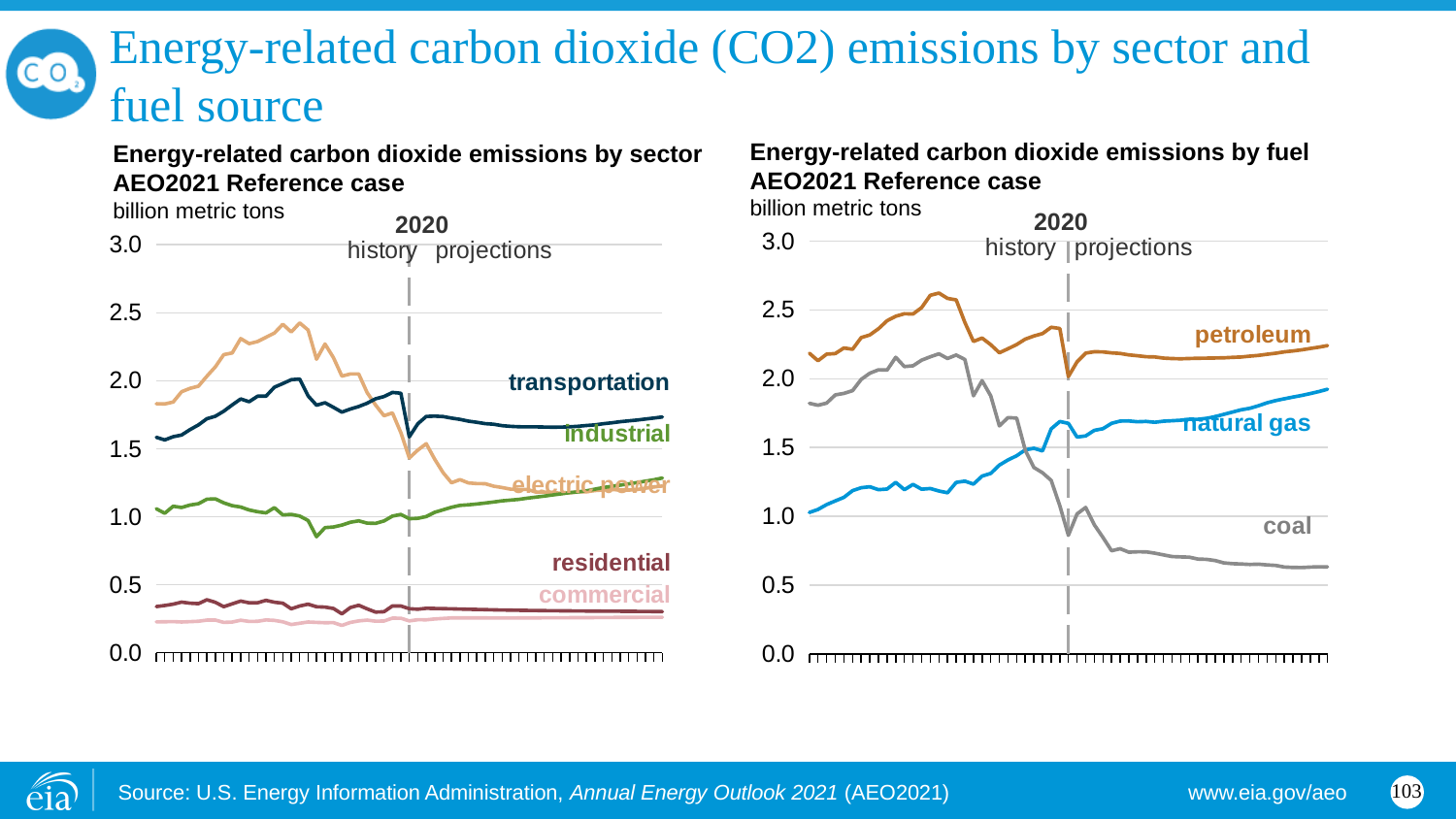
In the 'Energy-related carbon dioxide emissions by sector' chart, which is larger at the end of the projections, transportation or residential? transportation In the 'Energy-related carbon dioxide emissions by fuel' chart, is the value for petroleum at the end of the projections greater or less than 2.0? greater What unit is used on the y axis of both charts? billion metric tons How many series are labeled on the 'Energy-related carbon dioxide emissions by sector' chart on the left? 5 In the 'Energy-related carbon dioxide emissions by sector' chart, which sector has the lowest emissions at the end of the projection period? commercial What kind of chart is the 'Energy-related carbon dioxide emissions by sector' chart on the left? line chart In the 'Energy-related carbon dioxide emissions by fuel' chart, is the value for coal at the end of the projections greater or less than 1.0? less In the 'Energy-related carbon dioxide emissions by sector' chart, is the value for commercial at the end of the projections greater or less than 0.5? less In the 'Energy-related carbon dioxide emissions by fuel' chart, do coal emissions rise or fall over the projection period? fall In the 'Energy-related carbon dioxide emissions by fuel' chart, which fuel has the lowest emissions at the end of the projection period? coal How many series are labeled on the 'Energy-related carbon dioxide emissions by fuel' chart on the right? 3 In the 'Energy-related carbon dioxide emissions by fuel' chart, which fuel has the highest emissions at the end of the projection period? petroleum